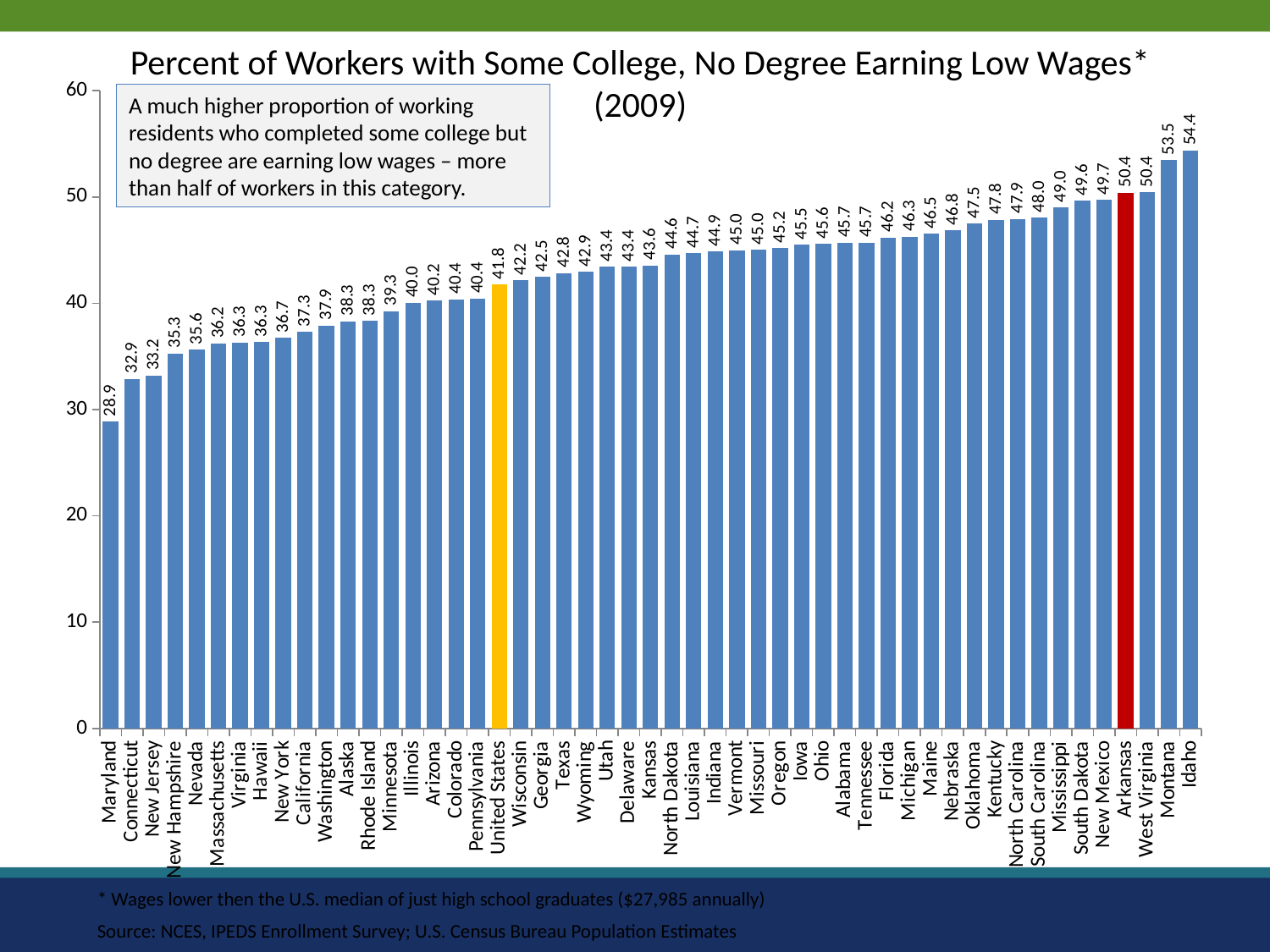
Which category has the highest value? Idaho What kind of chart is shown on the slide? bar chart What is the value for United States? 41.8 What is the value for Montana? 53.5 Do the values rise or fall from left to right along the x axis? rise What is the value for Arkansas? 50.4 Which category has the lowest value? Maryland What is the difference between the values for Arkansas and United States? 8.6 What is the difference between the values for Idaho and Maryland? 25.5 What is the value for Maryland? 28.9 Which is larger, the value for Texas or the value for Kansas? Kansas Which category is shown with a red bar? Arkansas